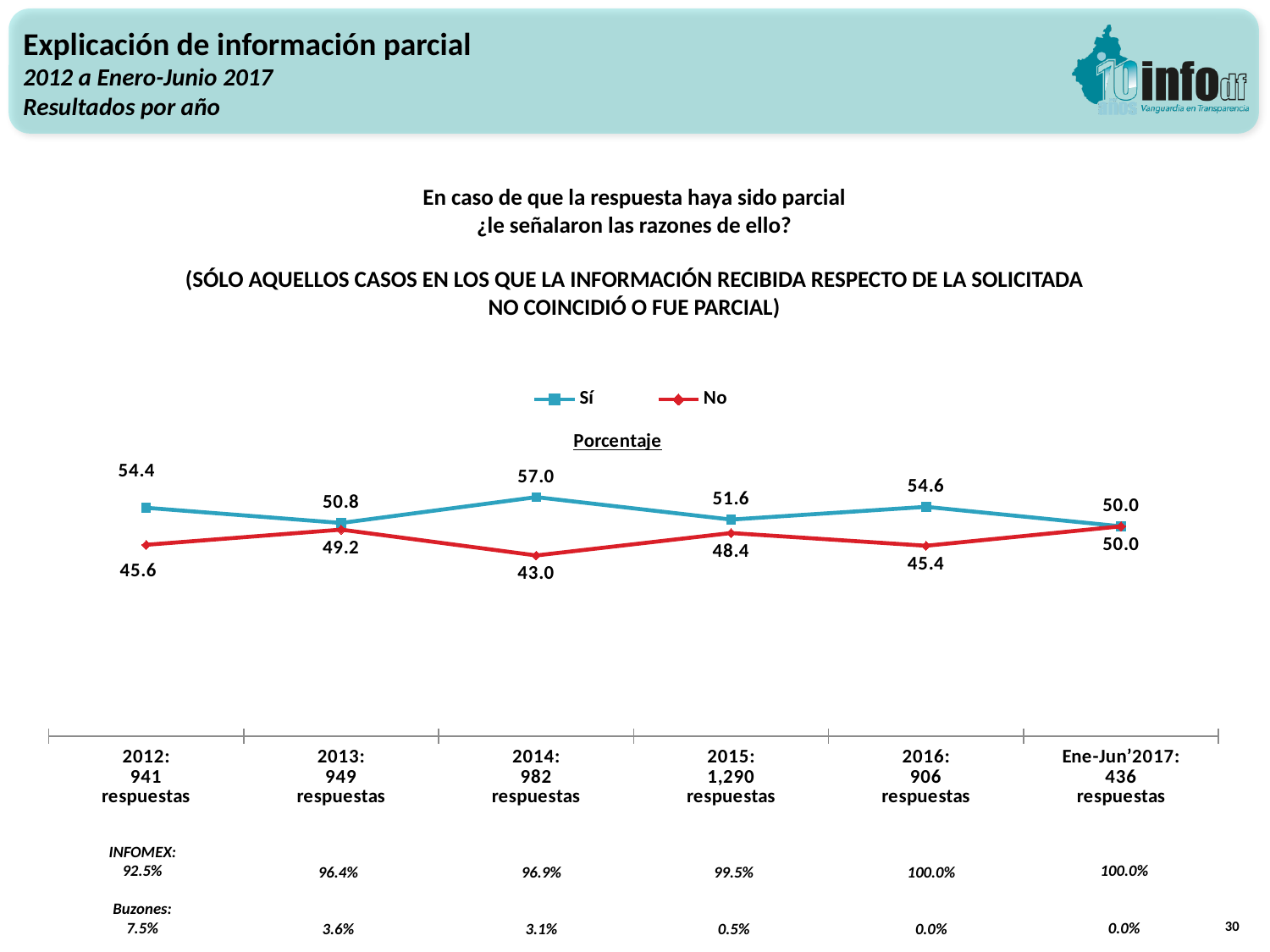
What kind of chart is shown on the slide? line chart What is the value of the "Sí" series for 2014? 57.0 What is the value of the "No" series for 2016? 45.4 Which series has the larger value in 2015, "Sí" or "No"? Sí Does the "No" series rise or fall from 2016 to Ene-Jun'2017? rise In which year does the "Sí" series reach its highest value? 2014 How many time periods are plotted on the x axis? 6 What is the difference between the "Sí" value in 2012 and the "Sí" value in 2013? 3.6 What is the value of the "No" series for 2012? 45.6 How many series does the legend list? 2 In which year does the "No" series reach its lowest value? 2014 What is the difference between the "Sí" and "No" values in 2014? 14.0